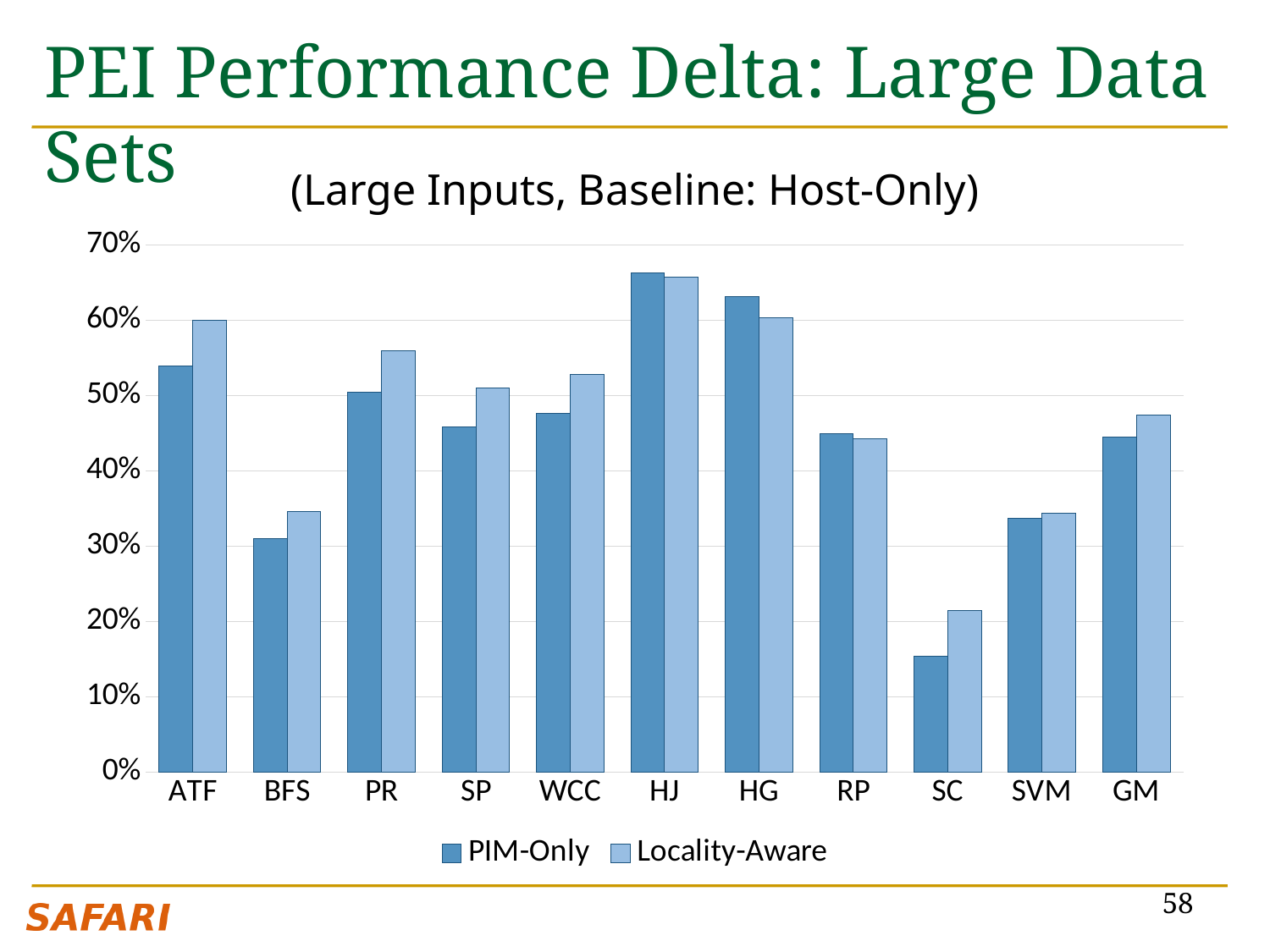
Is the Locality-Aware value for SC greater or less than 30%? less Which category has the highest PIM-Only value? HJ For ATF, which series has the larger value, PIM-Only or Locality-Aware? Locality-Aware Is the PIM-Only value for ATF greater or less than 50%? greater What are the two series named in the legend? PIM-Only and Locality-Aware What kind of chart is shown on the slide? Bar chart Which category has the lowest Locality-Aware value? SC Is the PIM-Only value for BFS greater or less than 40%? less For HG, which series has the larger value, PIM-Only or Locality-Aware? PIM-Only How many series does the legend list? 2 How many categories are shown on the x axis? 11 Which category has the lowest PIM-Only value? SC